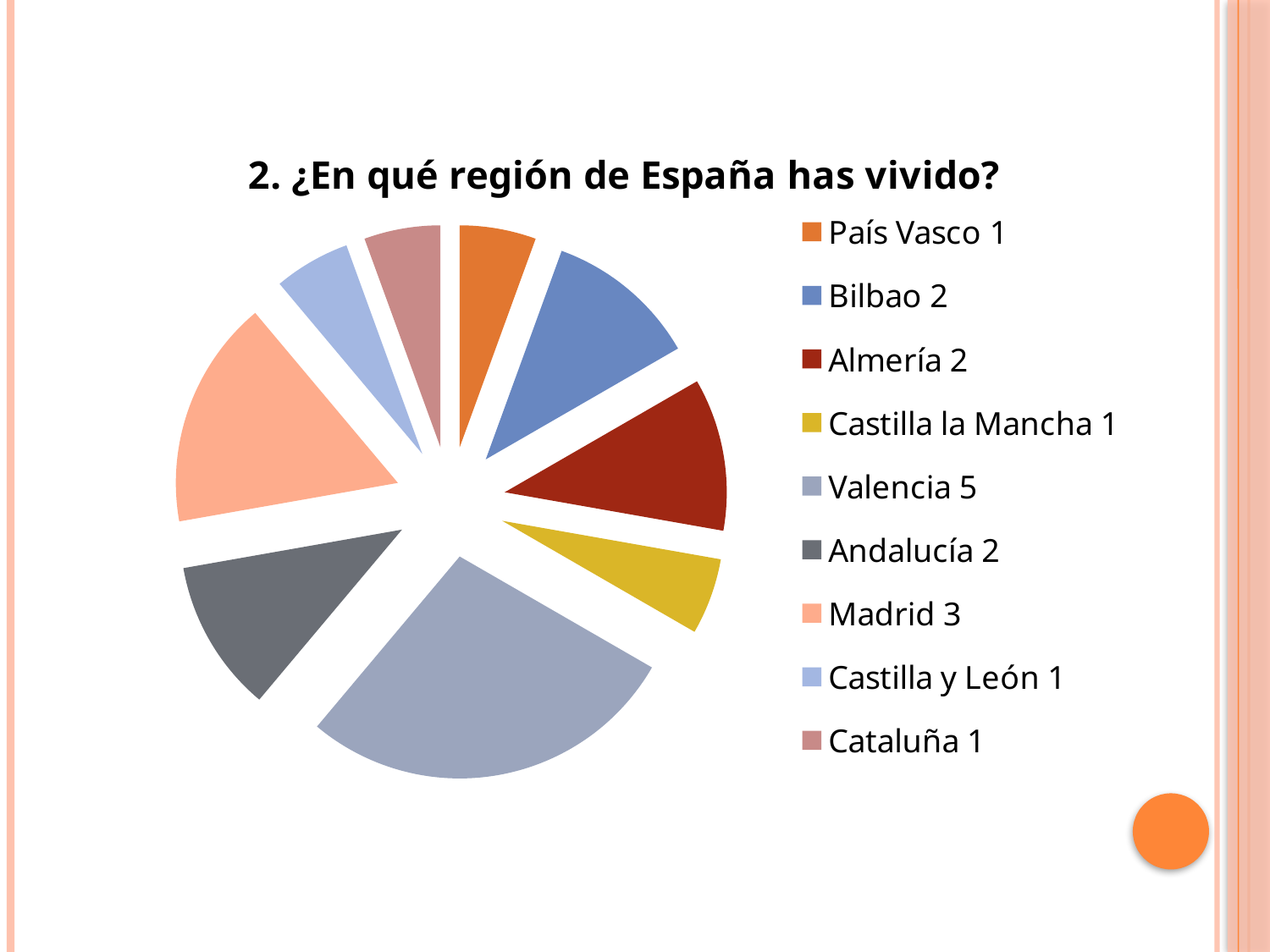
Which is larger, the value for Madrid or the value for Bilbao? Madrid What is the difference between the values for Valencia and Madrid? 2 What is the value shown for Madrid? 3 What is the total of all the values shown in the legend? 18 What is the value shown for Valencia? 5 Which region has the largest slice of the pie? Valencia What is the value shown for Cataluña? 1 Which region is represented by the dark red slice? Almería How many regions (slices) does the pie chart show? 9 What is the value shown for Andalucía? 2 What kind of chart is shown on the slide? pie chart What is the title of the chart? 2. ¿En qué región de España has vivido?